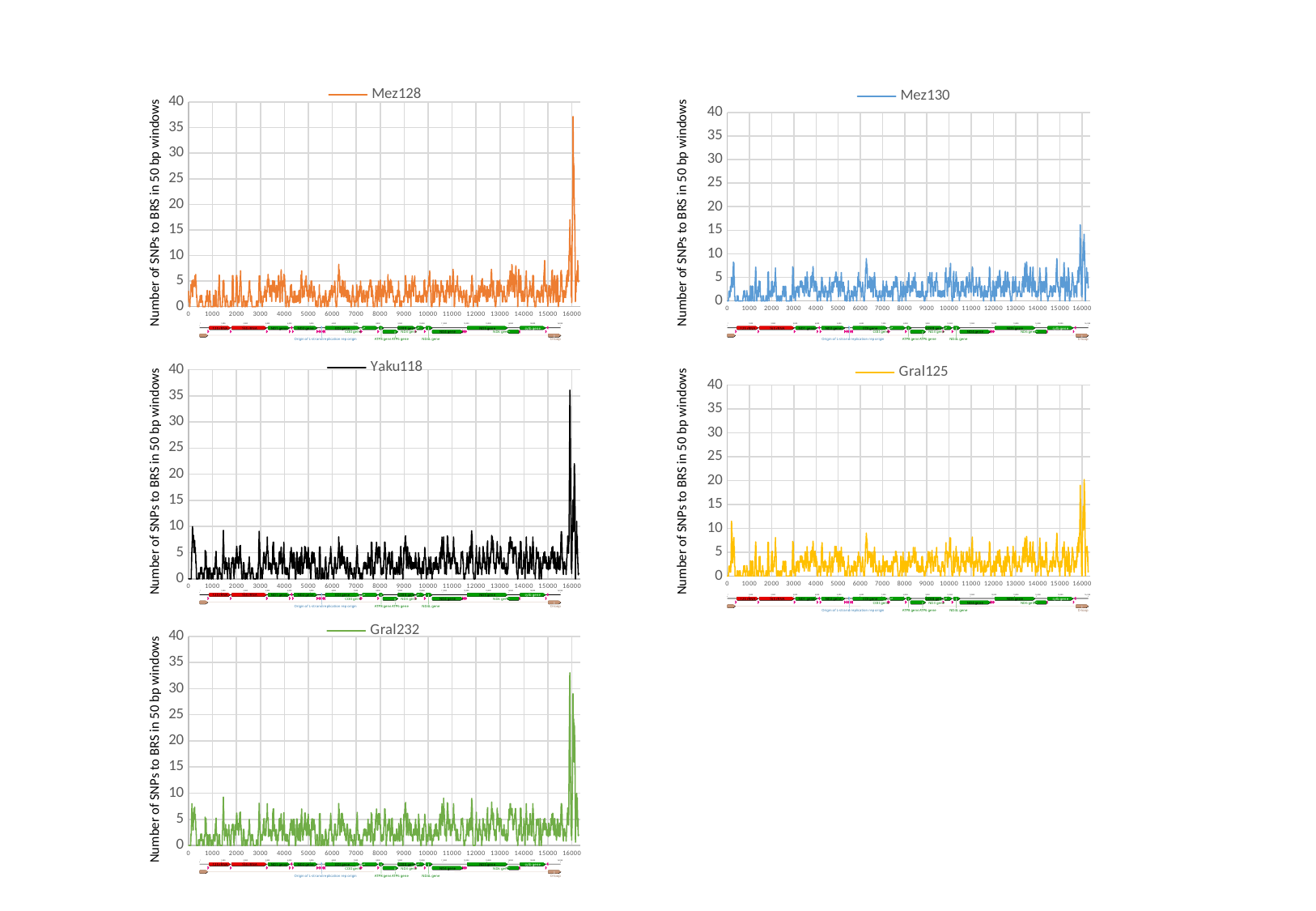
In the Mez130 chart, is the highest peak near position 16000 greater or less than 20? less What kind of chart is the Mez128 chart? line chart What is the name of the series shown in the top-right chart? Mez130 In the Gral125 chart, is the highest peak near position 16000 greater or less than 25? less How many line charts are shown on the slide? 5 Which chart has the lower maximum peak, Mez130 or Mez128? Mez130 In the Yaku118 chart, is the highest peak near position 16000 greater or less than 30? greater Which chart has the higher maximum peak, Gral125 or Yaku118? Yaku118 What is the y-axis label on the Yaku118 chart? Number of SNPs to BRS in 50 bp windows How many series does the legend of the Gral125 chart list? 1